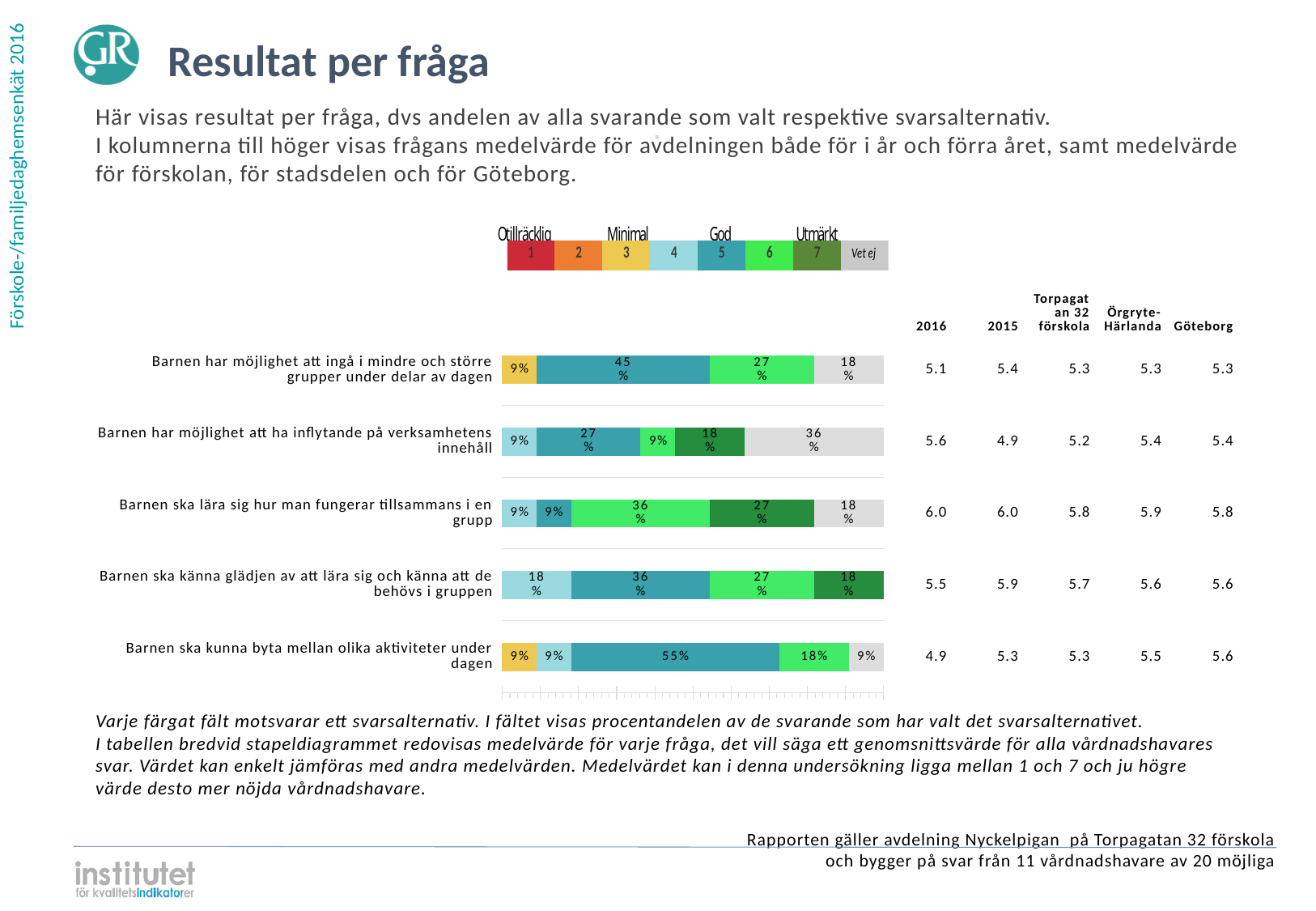
What percentage of respondents chose the highest rating (7, dark green) for 'Barnen ska lära sig hur man fungerar tillsammans i en grupp'? 27% What kind of chart is shown on the slide? stacked bar chart What is the largest segment value in the bar for 'Barnen ska kunna byta mellan olika aktiviteter under dagen'? 55% Which is larger for 'Barnen ska lära sig hur man fungerar tillsammans i en grupp': the rating-6 share or the rating-7 share? rating-6 share (36%) How many questions (categories) are plotted in the bar chart? 5 What percentage of respondents chose 'Vet ej' for 'Barnen har möjlighet att ha inflytande på verksamhetens innehåll'? 36% What are the four rating labels shown above the colour legend? Otillräcklig, Minimal, God, Utmärkt What is the 2016 mean value shown for 'Barnen ska lära sig hur man fungerar tillsammans i en grupp'? 6.0 What is the Göteborg mean value shown for 'Barnen ska kunna byta mellan olika aktiviteter under dagen'? 5.6 What percentage of respondents chose rating 5 (teal) for 'Barnen har möjlighet att ingå i mindre och större grupper under delar av dagen'? 45% Which question has the largest 'Vet ej' (grey) share? Barnen har möjlighet att ha inflytande på verksamhetens innehåll What is the difference between the rating-5 share (36%) and the rating-7 share (18%) for 'Barnen ska känna glädjen av att lära sig och känna att de behövs i gruppen'? 18 percentage points